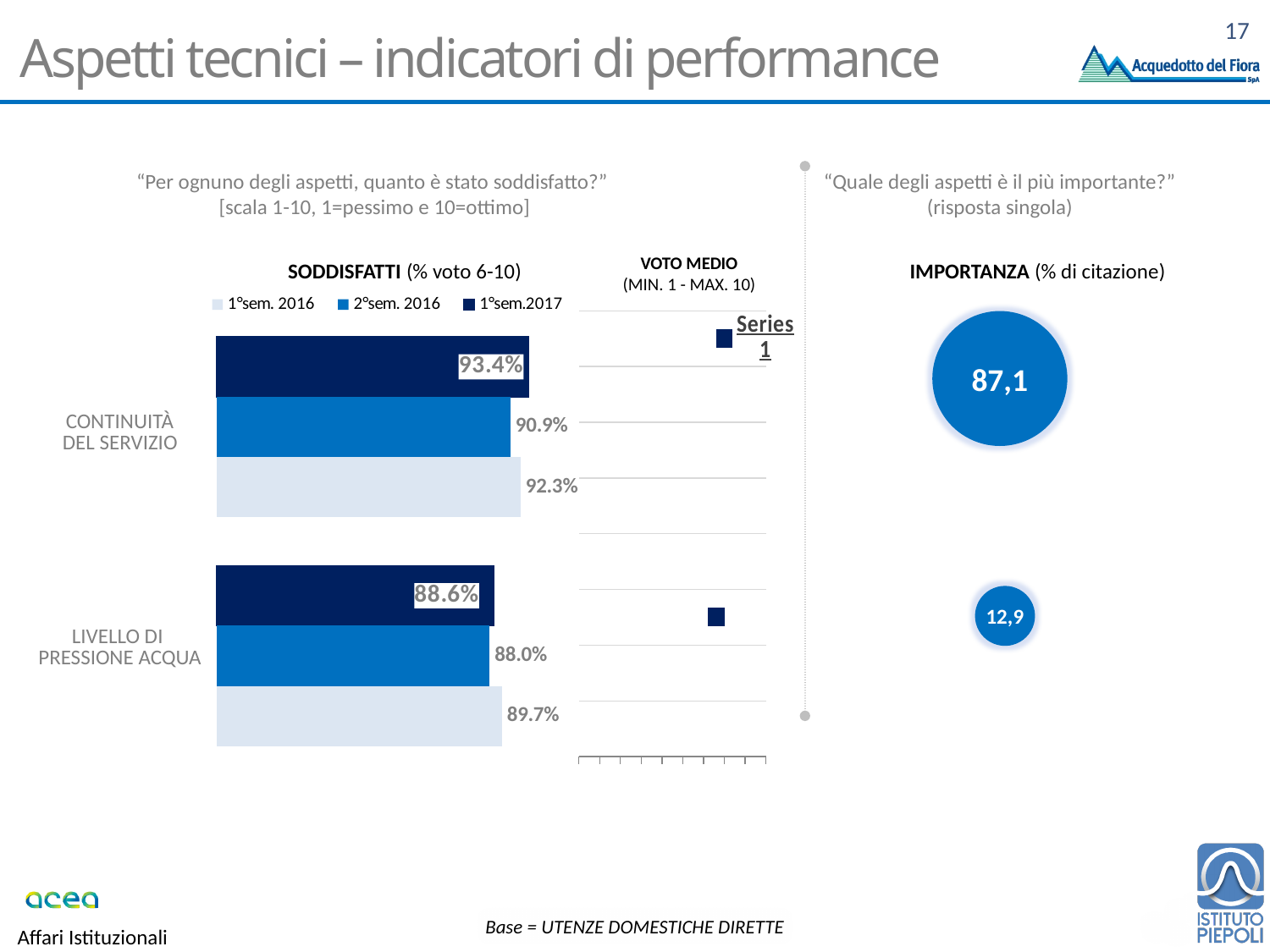
In the SODDISFATTI chart, which series has the lowest value for LIVELLO DI PRESSIONE ACQUA? 2°sem. 2016 In the SODDISFATTI chart, what is the difference between the 1°sem.2017 values for CONTINUITÀ DEL SERVIZIO and LIVELLO DI PRESSIONE ACQUA? 4.8% In the SODDISFATTI chart, what is the value for LIVELLO DI PRESSIONE ACQUA in 1°sem. 2016? 89.7% In the IMPORTANZA section, what is the value shown for the larger circle? 87,1 In the SODDISFATTI chart, what is the value for LIVELLO DI PRESSIONE ACQUA in 2°sem. 2016? 88.0% How many series does the legend of the SODDISFATTI chart list? 3 In the SODDISFATTI chart, what is the value for CONTINUITÀ DEL SERVIZIO in 1°sem. 2016? 92.3% In the SODDISFATTI chart, which is larger for CONTINUITÀ DEL SERVIZIO: the 2°sem. 2016 value or the 1°sem. 2016 value? 1°sem. 2016 In the SODDISFATTI chart, which series has the highest value for CONTINUITÀ DEL SERVIZIO? 1°sem.2017 How many categories are shown in the SODDISFATTI chart? 2 In the SODDISFATTI chart, what is the value for CONTINUITÀ DEL SERVIZIO in 1°sem.2017? 93.4% What kind of chart is the SODDISFATTI chart? Bar chart